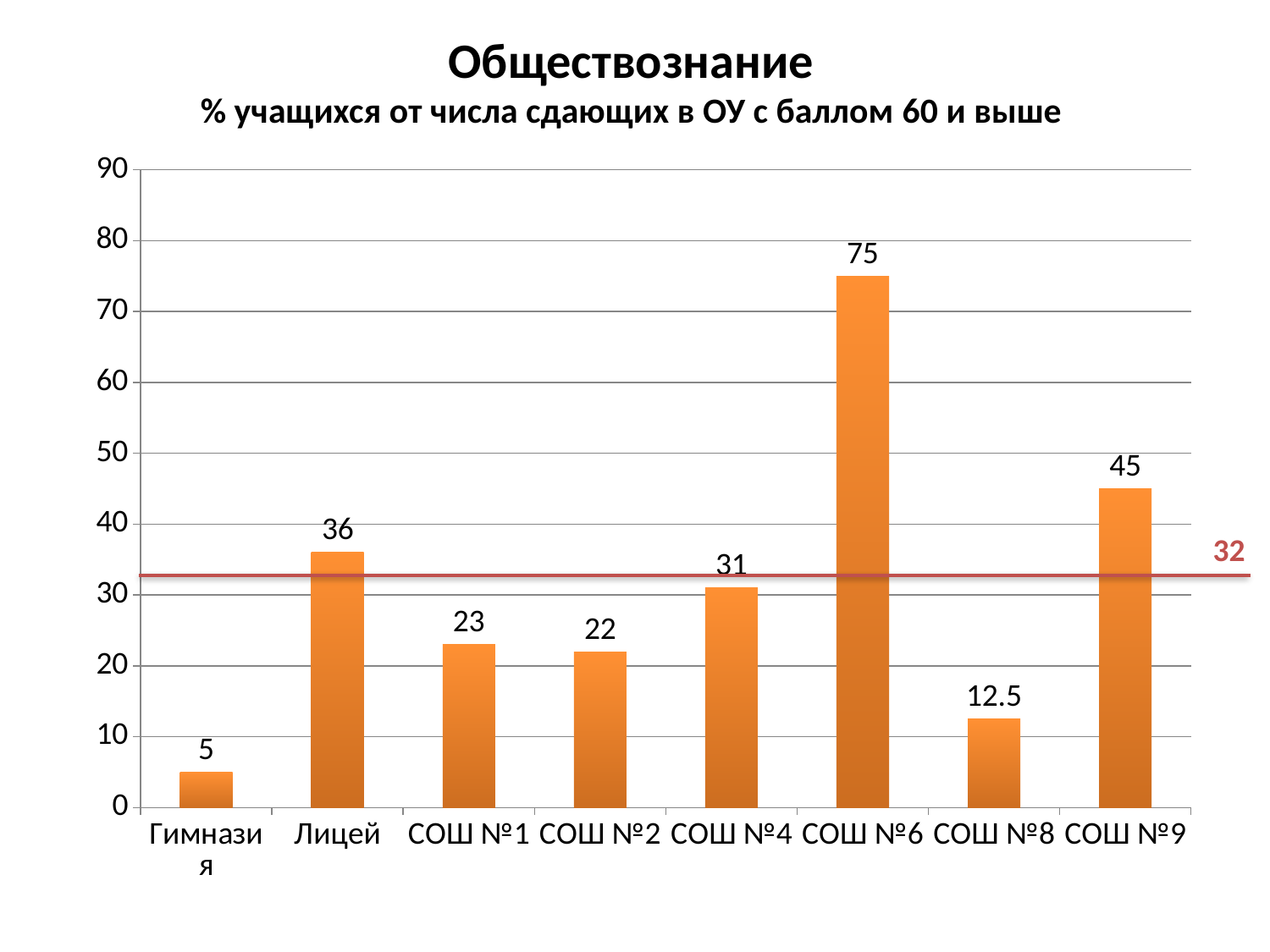
Which category has the lowest value? Гимназия What is the value for Лицей? 36 Which is larger, the value for СОШ №1 or the value for СОШ №4? СОШ №4 What value is marked by the red horizontal line? 32 Is the value for СОШ №9 greater or less than 40? greater What kind of chart is this? bar chart What is the difference between the values for СОШ №6 and СОШ №9? 30 What is the title of the chart? Обществознание What is the value for СОШ №6? 75 Which category has the highest value? СОШ №6 What is the value for СОШ №8? 12.5 How many categories are shown on the x axis? 8